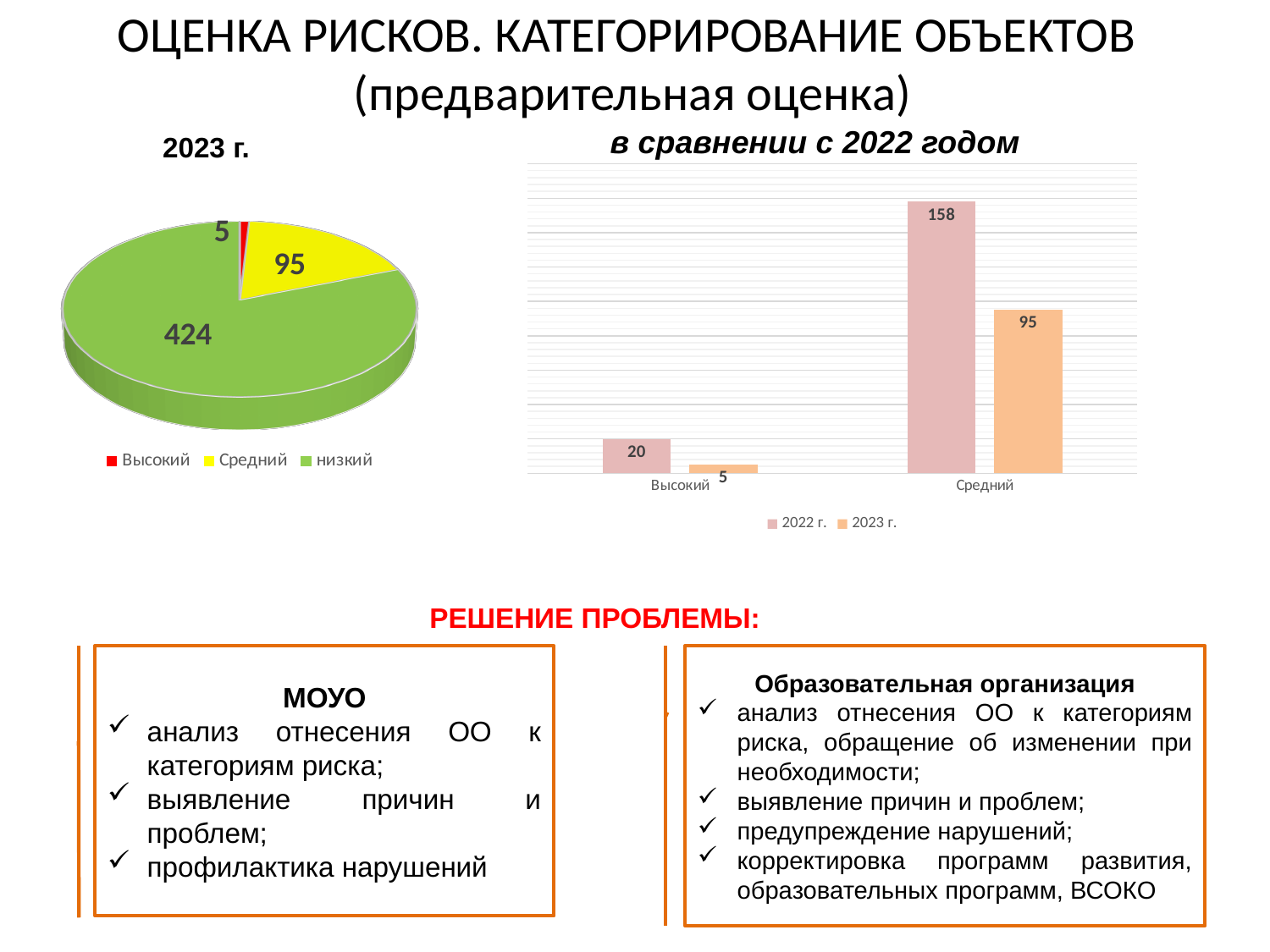
In the bar chart titled "в сравнении с 2022 годом", how many series does the legend list? 2 In the bar chart titled "в сравнении с 2022 годом", which is larger for "Высокий": the "2022 г." value or the "2023 г." value? 2022 г. In the bar chart titled "в сравнении с 2022 годом", what is the value for "Высокий" in the "2023 г." series? 5 In the pie chart titled "2023 г.", how many categories does the legend list? 3 In the pie chart titled "2023 г.", which category has the smallest value? Высокий In the pie chart titled "2023 г.", what is the value for the "низкий" category? 424 In the pie chart titled "2023 г.", which category has the largest value? низкий In the bar chart titled "в сравнении с 2022 годом", what is the value for "Средний" in the "2022 г." series? 158 In the pie chart titled "2023 г.", what is the value for the "Средний" category? 95 In the bar chart titled "в сравнении с 2022 годом", what is the difference between the "2022 г." and "2023 г." values for "Средний"? 63 In the pie chart titled "2023 г.", what colour represents the "Высокий" category? Red What kind of chart is the one titled "в сравнении с 2022 годом"? Bar chart